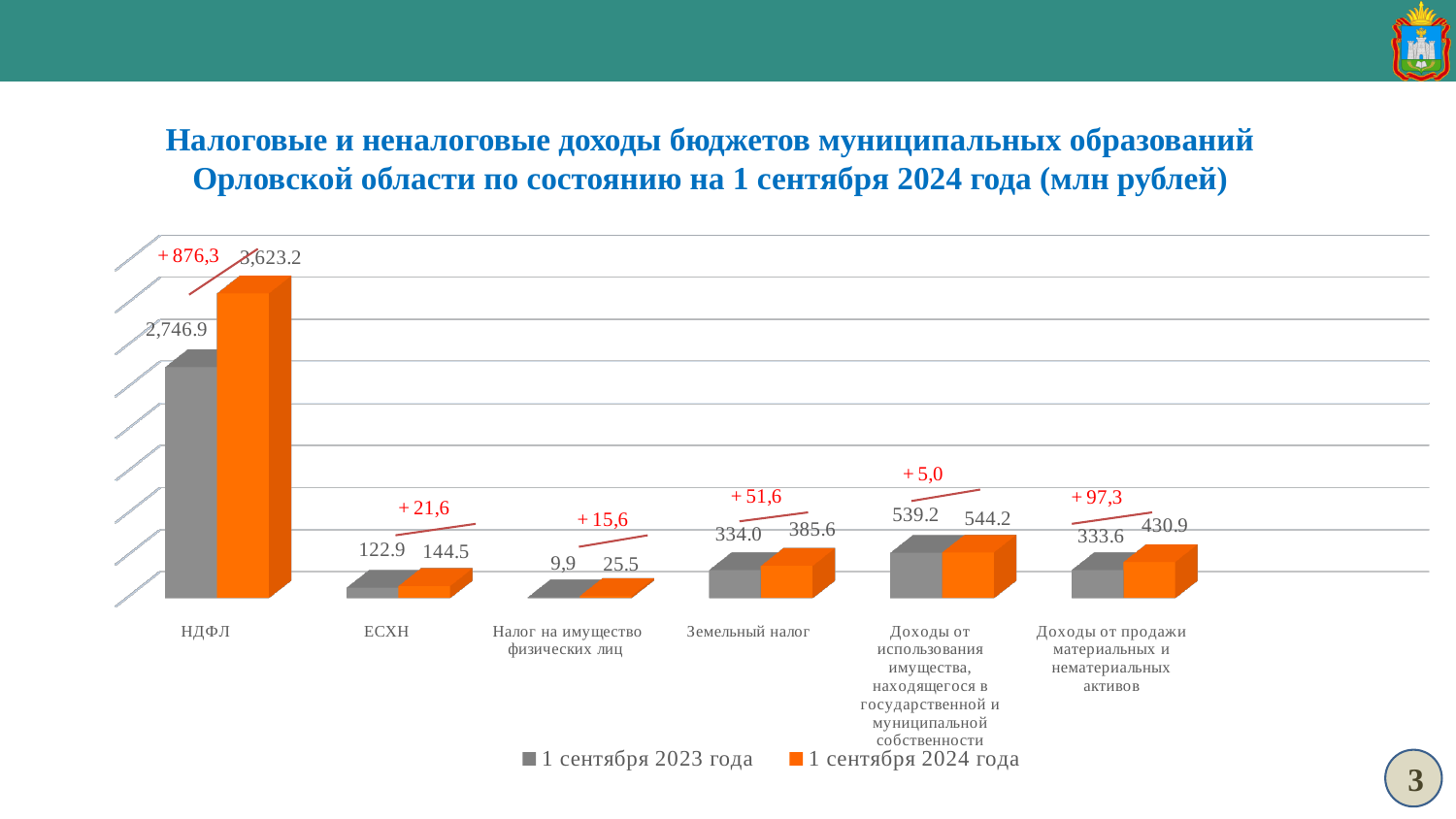
Which is larger for Земельный налог: the value for 1 сентября 2023 года or 1 сентября 2024 года? 1 сентября 2024 года What is the value for Налог на имущество физических лиц in the series 1 сентября 2023 года? 9,9 How many categories are shown on the x axis? 6 Which colour represents the series 1 сентября 2024 года? Orange What is the value for НДФЛ in the series 1 сентября 2024 года? 3,623.2 What is the value for ЕСХН in the series 1 сентября 2023 года? 122.9 What kind of chart is shown on the slide? Bar chart What is the difference between the 2024 and 2023 values for Доходы от продажи материальных и нематериальных активов? 97.3 What is the value for Земельный налог in the series 1 сентября 2024 года? 385.6 Which category has the highest value in the series 1 сентября 2024 года? НДФЛ How many series does the legend list? 2 Which category has the lowest value in the series 1 сентября 2023 года? Налог на имущество физических лиц